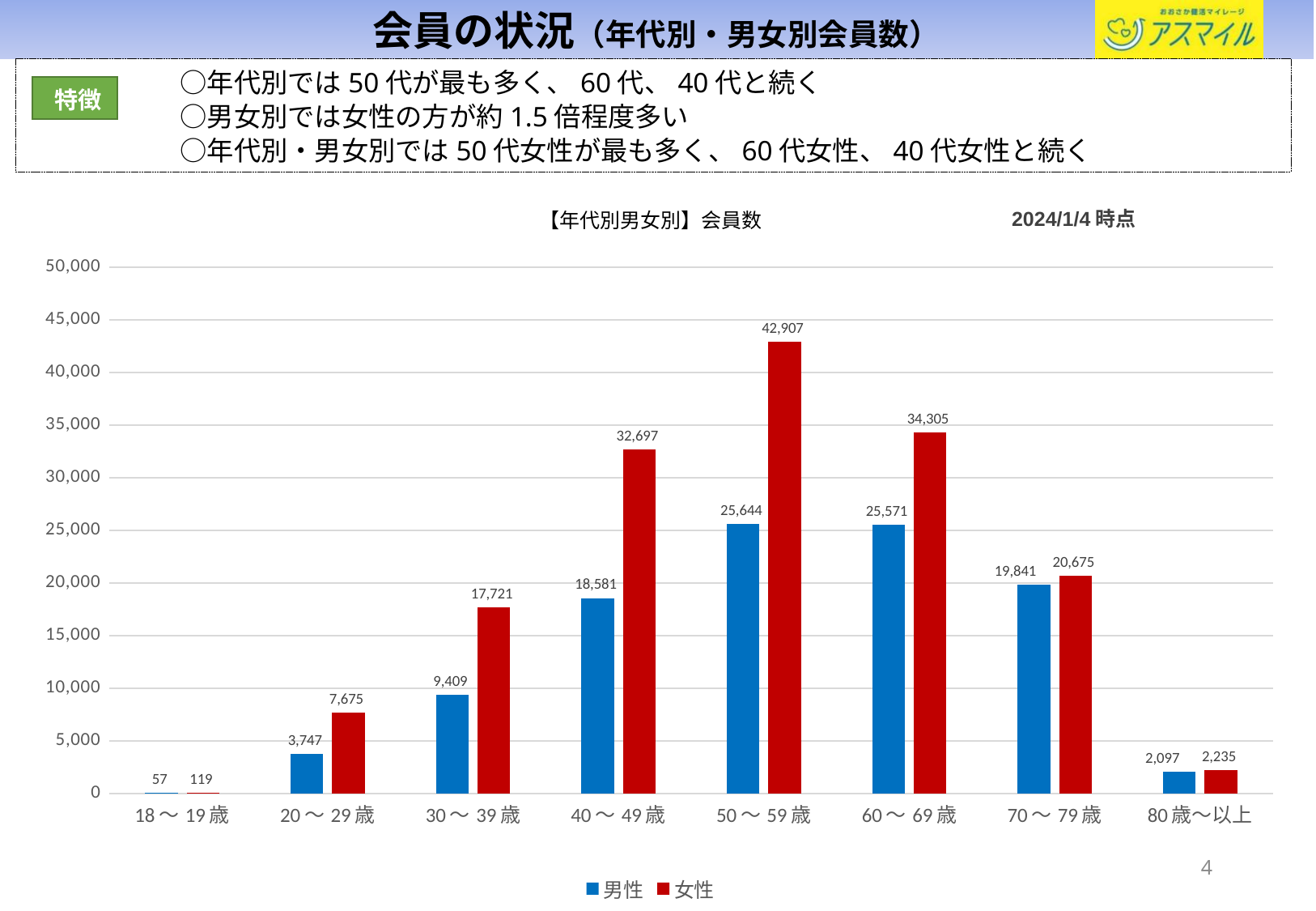
How many age categories are shown on the x axis? 8 What is the value for 男性 in the 40～49歳 category? 18,581 What is the value for 女性 in the 80歳～以上 category? 2,235 Which age category has the highest value for 女性? 50～59歳 Is the value for 女性 in the 30～39歳 category greater or less than 15,000? greater What is the value for 女性 in the 50～59歳 category? 42,907 What kind of chart is shown on the slide? bar chart Which age category has the lowest value for 男性? 18～19歳 What date is given next to the chart title? 2024/1/4 時点 What is the difference between the 女性 and 男性 values in the 60～69歳 category? 8,734 Which is larger in the 70～79歳 category, the 男性 value or the 女性 value? 女性 How many series does the legend list? 2